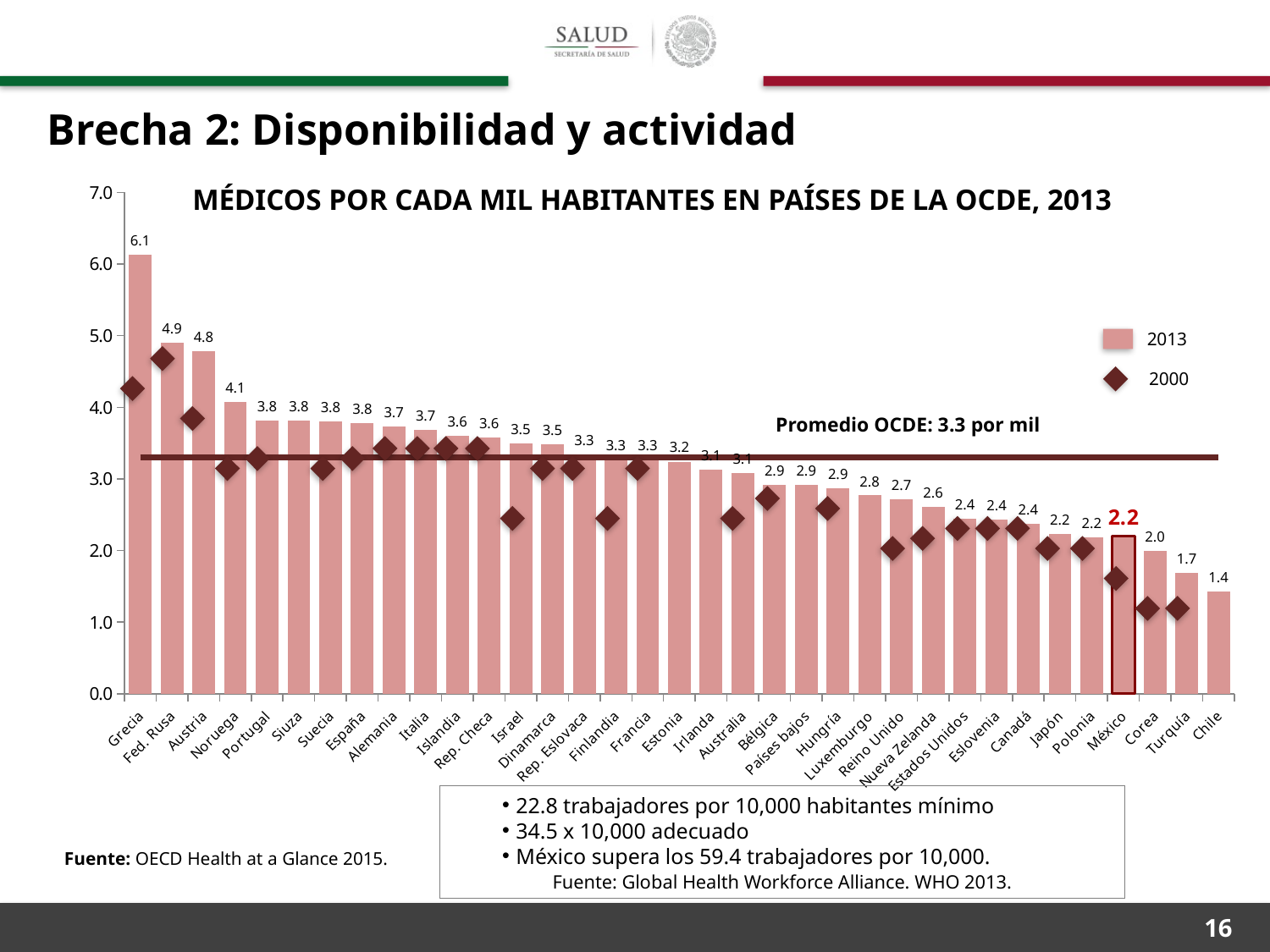
How many series does the legend list? 2 Which country has the lowest 2013 value? Chile Is the 2000 value for Corea greater or less than 2.0? less What is the 2013 value for Grecia? 6.1 What is the OECD average (Promedio OCDE) indicated on the chart? 3.3 por mil What is the 2013 value for Turquía? 1.7 Which country has the highest 2013 value? Grecia Which has a larger 2013 value, Austria or Noruega? Austria What is the difference between the 2013 values for Grecia and Chile? 4.7 How many countries are shown on the x axis? 35 What is the 2013 value for México? 2.2 What kind of chart is used to plot the 2013 series? bar chart